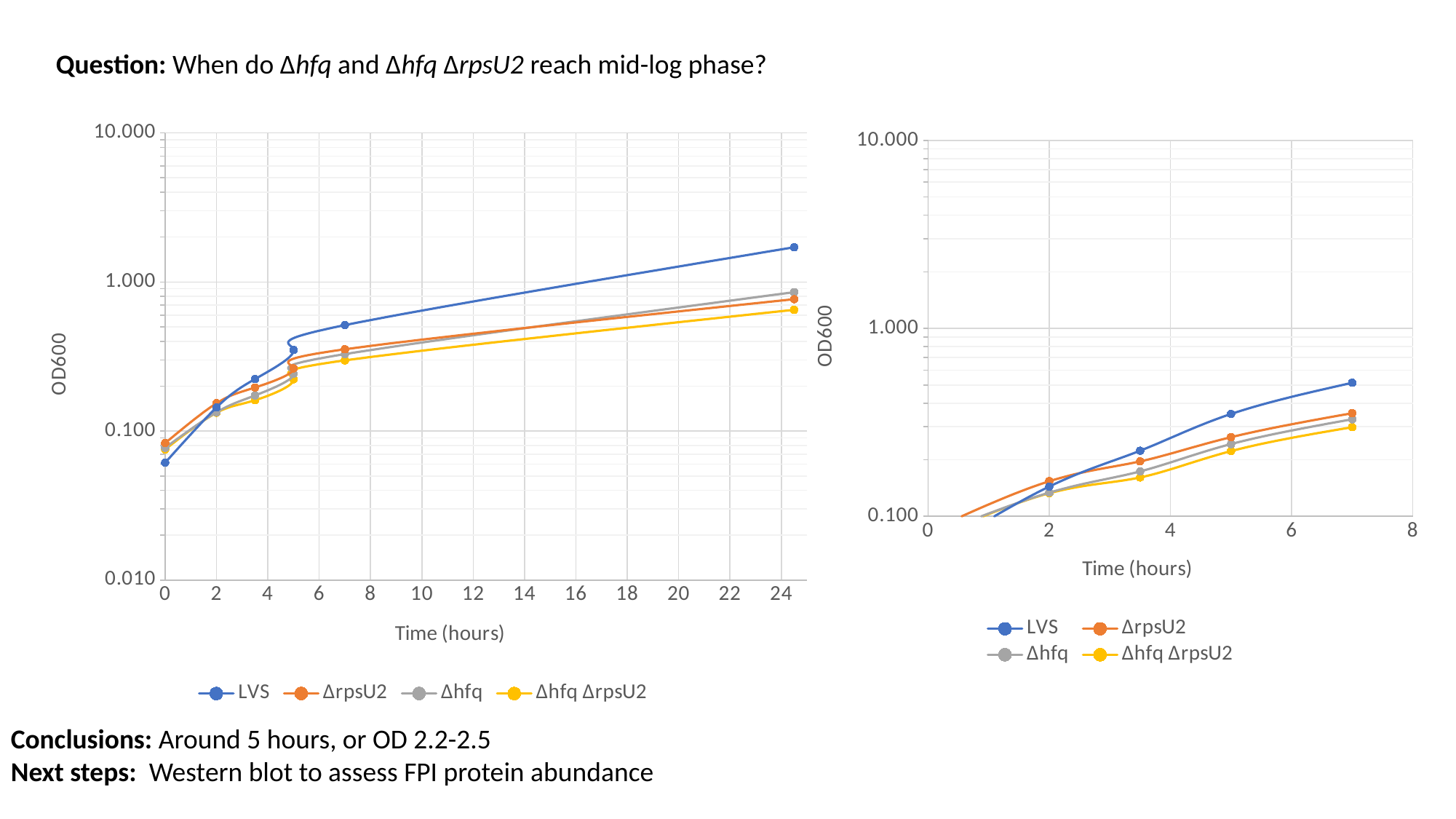
In the left chart, is the OD600 value for LVS at 0 hours greater or less than 0.100? less In the left chart, which series has the highest OD600 at the final time point (around 24 hours)? LVS What is the label of the y axis on the right chart? OD600 What kind of chart is the chart on the left of the slide? line chart In the right chart, which series has the lowest OD600 at 5 hours? Δhfq ΔrpsU2 In the left chart, is the OD600 value for Δhfq at the final time point greater or less than 1.000? less In the right chart, which series has the highest OD600 at 7 hours? LVS In the left chart, is the OD600 value for LVS at the final time point greater or less than 1.000? greater In the left chart, which series has the lowest OD600 at the final time point (around 24 hours)? Δhfq ΔrpsU2 How many series does the legend of the left chart list? 4 In the left chart, do the OD600 values for LVS rise or fall as time increases? rise